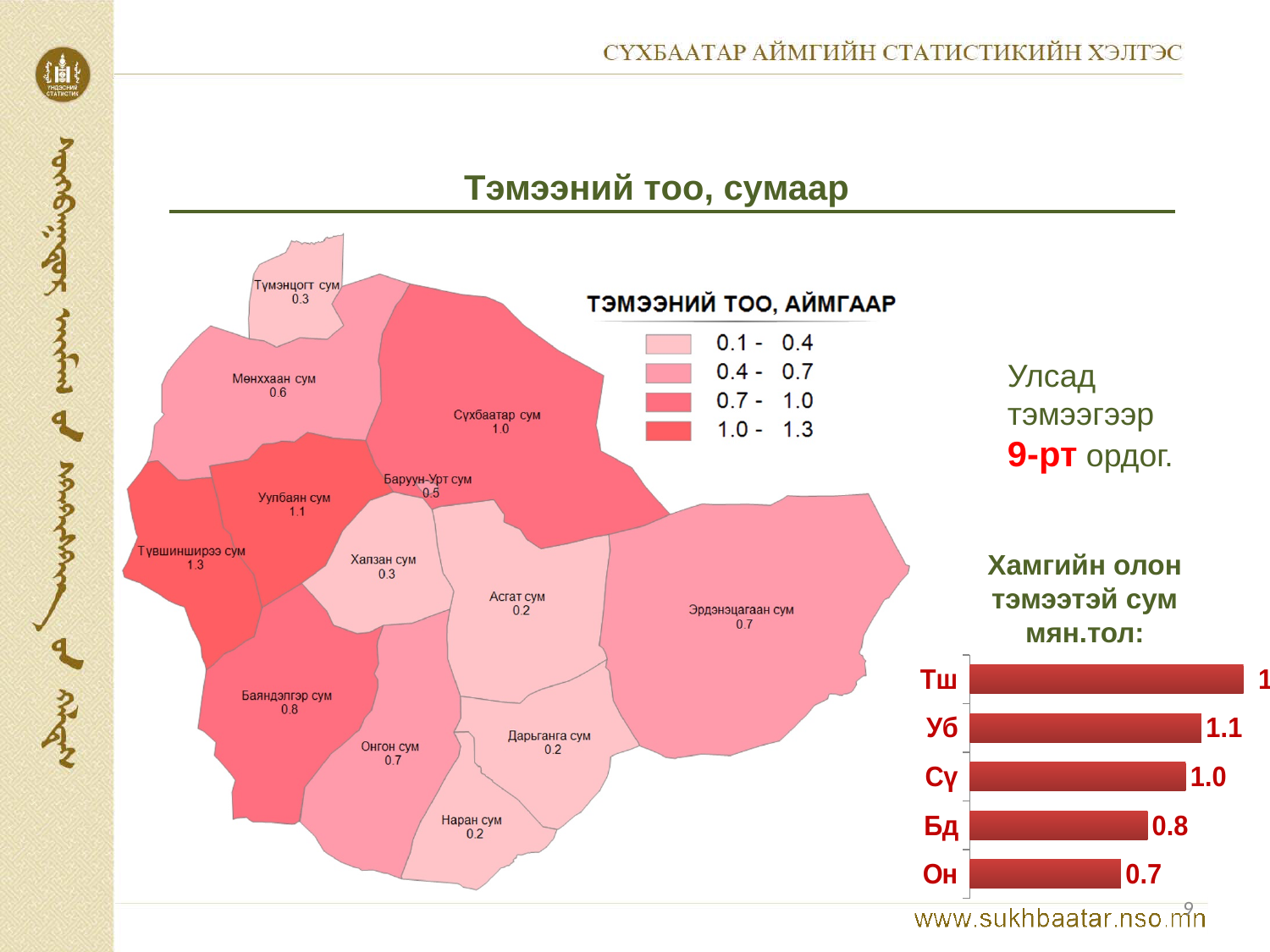
How many categories are shown in the bar chart titled 'Хамгийн олон тэмээтэй сум мян.тол:'? 5 In the bar chart titled 'Хамгийн олон тэмээтэй сум мян.тол:', which category has the lowest value? Он In the bar chart titled 'Хамгийн олон тэмээтэй сум мян.тол:', what is the value for Сү? 1.0 In the bar chart titled 'Хамгийн олон тэмээтэй сум мян.тол:', which category has the longest bar? Тш In the bar chart titled 'Хамгийн олон тэмээтэй сум мян.тол:', what is the difference between the values for Уб and Он? 0.4 In the bar chart titled 'Хамгийн олон тэмээтэй сум мян.тол:', what is the value for Он? 0.7 In the bar chart titled 'Хамгийн олон тэмээтэй сум мян.тол:', what is the value for Бд? 0.8 On the map titled 'Тэмээний тоо, сумаар', what value is shown for Түвшинширээ сум? 1.3 In the bar chart titled 'Хамгийн олон тэмээтэй сум мян.тол:', what is the value for Уб? 1.1 What kind of chart is the one titled 'Хамгийн олон тэмээтэй сум мян.тол:'? Bar chart On the map titled 'Тэмээний тоо, сумаар', what value is shown for Эрдэнэцагаан сум? 0.7 In the bar chart titled 'Хамгийн олон тэмээтэй сум мян.тол:', which is larger, the value for Сү or the value for Бд? Сү